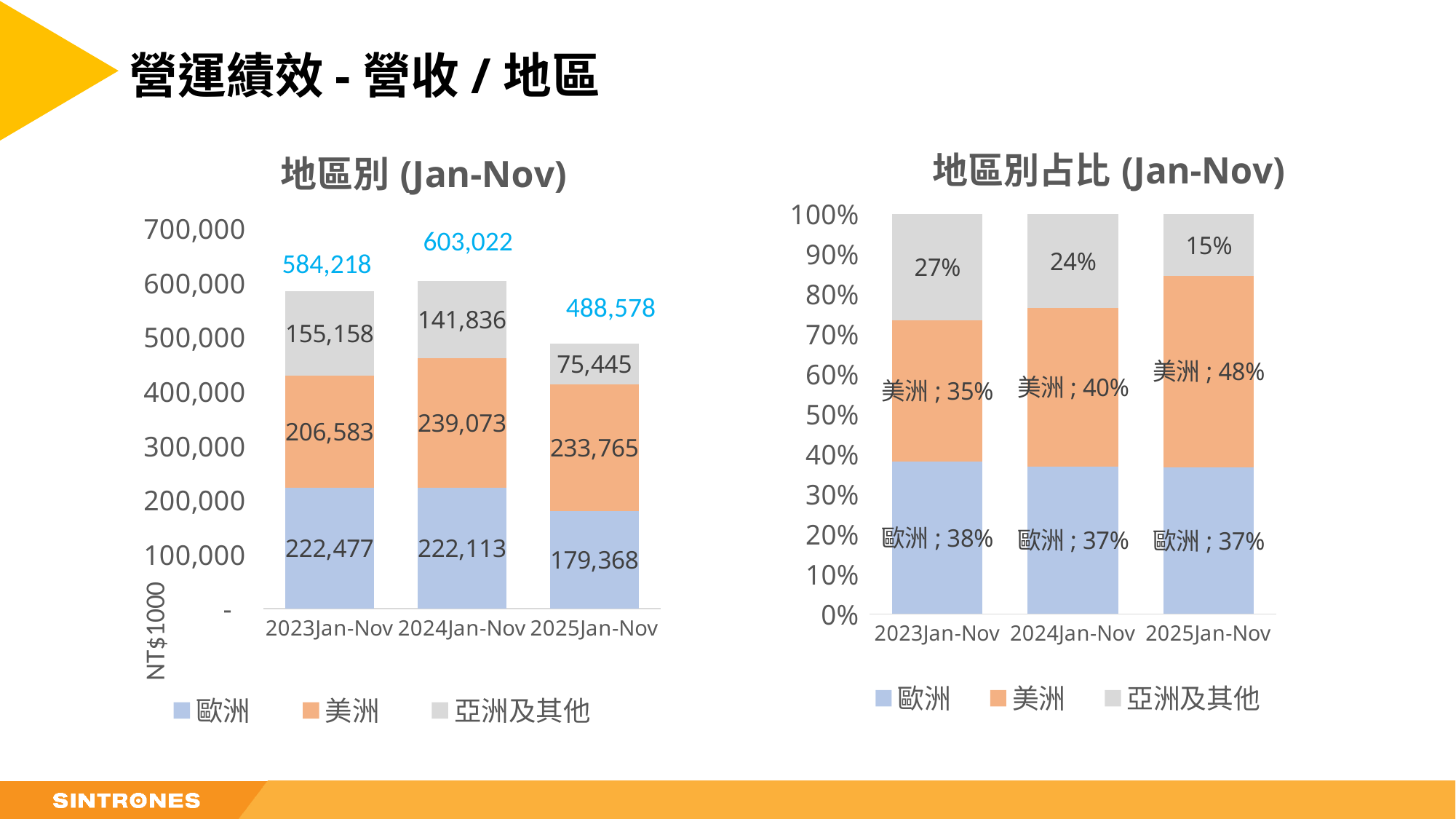
In the chart titled 地區別 (Jan-Nov), what is the value for 美洲 in 2024Jan-Nov? 239,073 In the chart titled 地區別占比 (Jan-Nov), what is the share for 美洲 in 2025Jan-Nov? 48% In the chart titled 地區別占比 (Jan-Nov), does the share of 亞洲及其他 rise or fall from 2023Jan-Nov to 2025Jan-Nov? fall What kind of chart is the chart titled 地區別占比 (Jan-Nov)? stacked bar chart In the chart titled 地區別 (Jan-Nov), which period has the highest total? 2024Jan-Nov In the chart titled 地區別 (Jan-Nov), what unit is shown on the vertical axis label? NT$1000 In the chart titled 地區別 (Jan-Nov), what is the total of the stacked bar for 2023Jan-Nov? 584,218 In the chart titled 地區別 (Jan-Nov), how many series does the legend list? 3 In the chart titled 地區別 (Jan-Nov), what is the value for 亞洲及其他 in 2025Jan-Nov? 75,445 In the chart titled 地區別 (Jan-Nov), is the 美洲 value for 2025Jan-Nov larger or smaller than the 美洲 value for 2023Jan-Nov? larger In the chart titled 地區別 (Jan-Nov), what is the difference between the 歐洲 values for 2023Jan-Nov and 2025Jan-Nov? 43,109 In the chart titled 地區別占比 (Jan-Nov), what is the share for 亞洲及其他 in 2023Jan-Nov? 27%